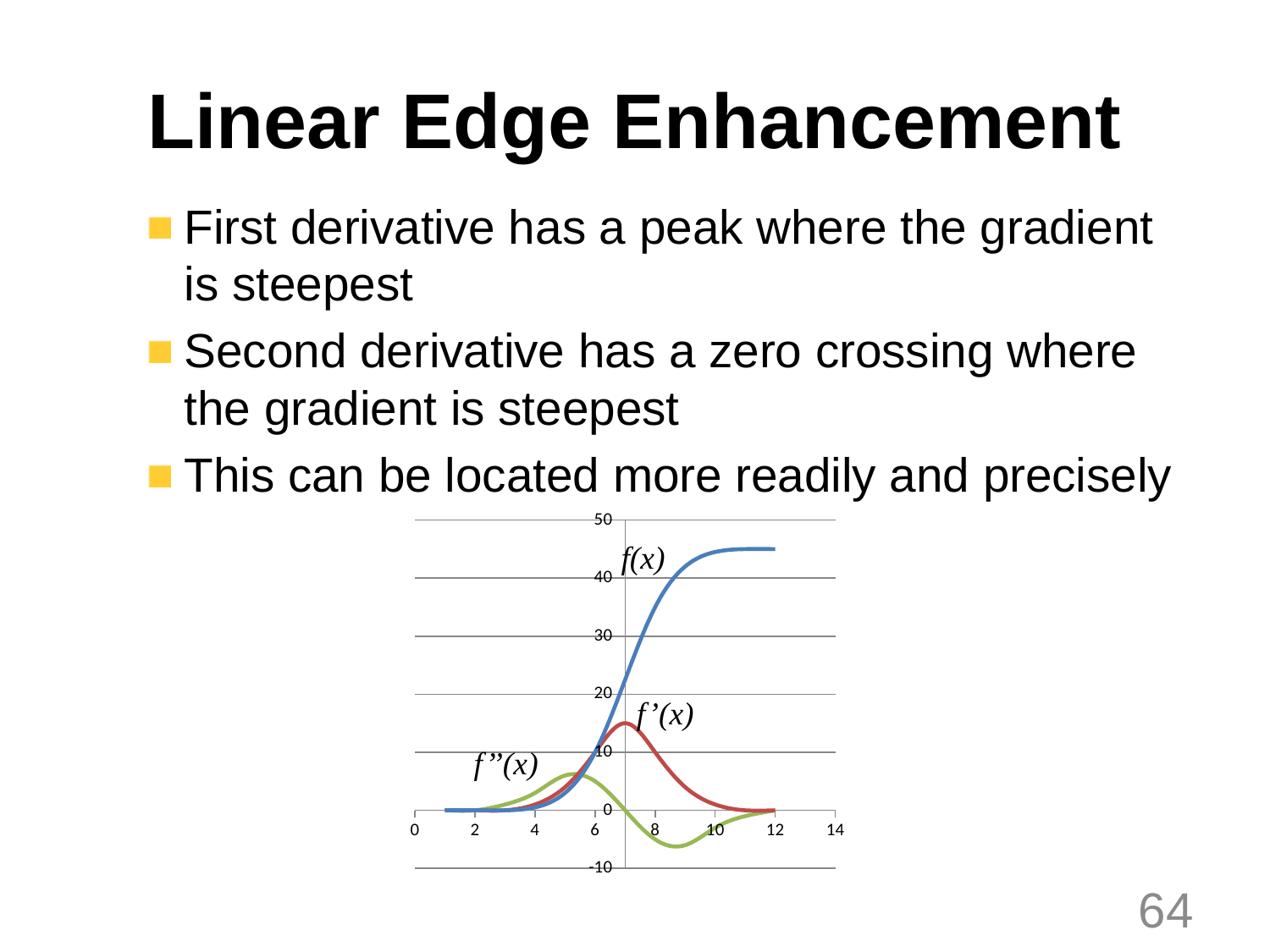
At x = 8, which is larger, f(x) or f'(x)? f(x) What kind of chart is shown on the slide? line chart Is the maximum value of f(x) greater or less than 40? greater Which curve reaches the lowest value on the chart? f''(x) How many curves are plotted on the chart? 3 Does f(x) rise or fall as x increases along the x axis? rises Is the peak value of f'(x) greater or less than 10? greater Which curve is drawn in blue? f(x) Is the peak value of f'(x) greater or less than 20? less Which curve reaches the highest value on the chart? f(x)